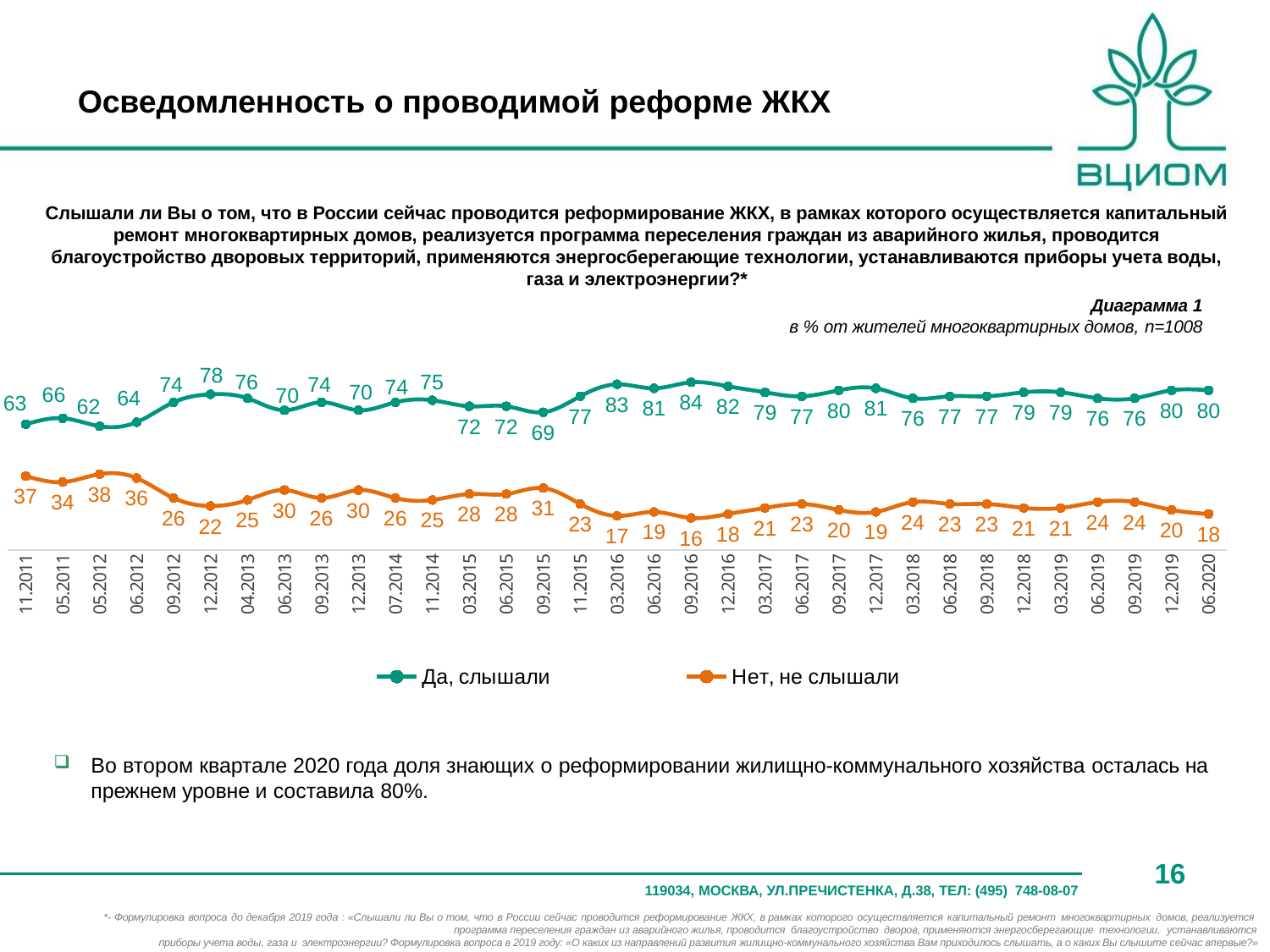
What is the name of the series drawn in orange? Нет, не слышали At which date does the "Да, слышали" series reach its highest value? 09.2016 What is the highest value of the "Нет, не слышали" series? 38 What is the value for "Нет, не слышали" at 06.2020? 18 What type of chart is shown on the slide? line chart What is the difference between "Да, слышали" and "Нет, не слышали" at 06.2020? 62 How many data points does each series have? 33 What is the value for "Да, слышали" at 06.2020? 80 At which date does the "Нет, не слышали" series reach its lowest value? 09.2016 How many series does the legend list? 2 Which is larger: the "Да, слышали" value at 09.2015 or at 11.2015? 11.2015 What is the value for "Да, слышали" at 12.2012? 78